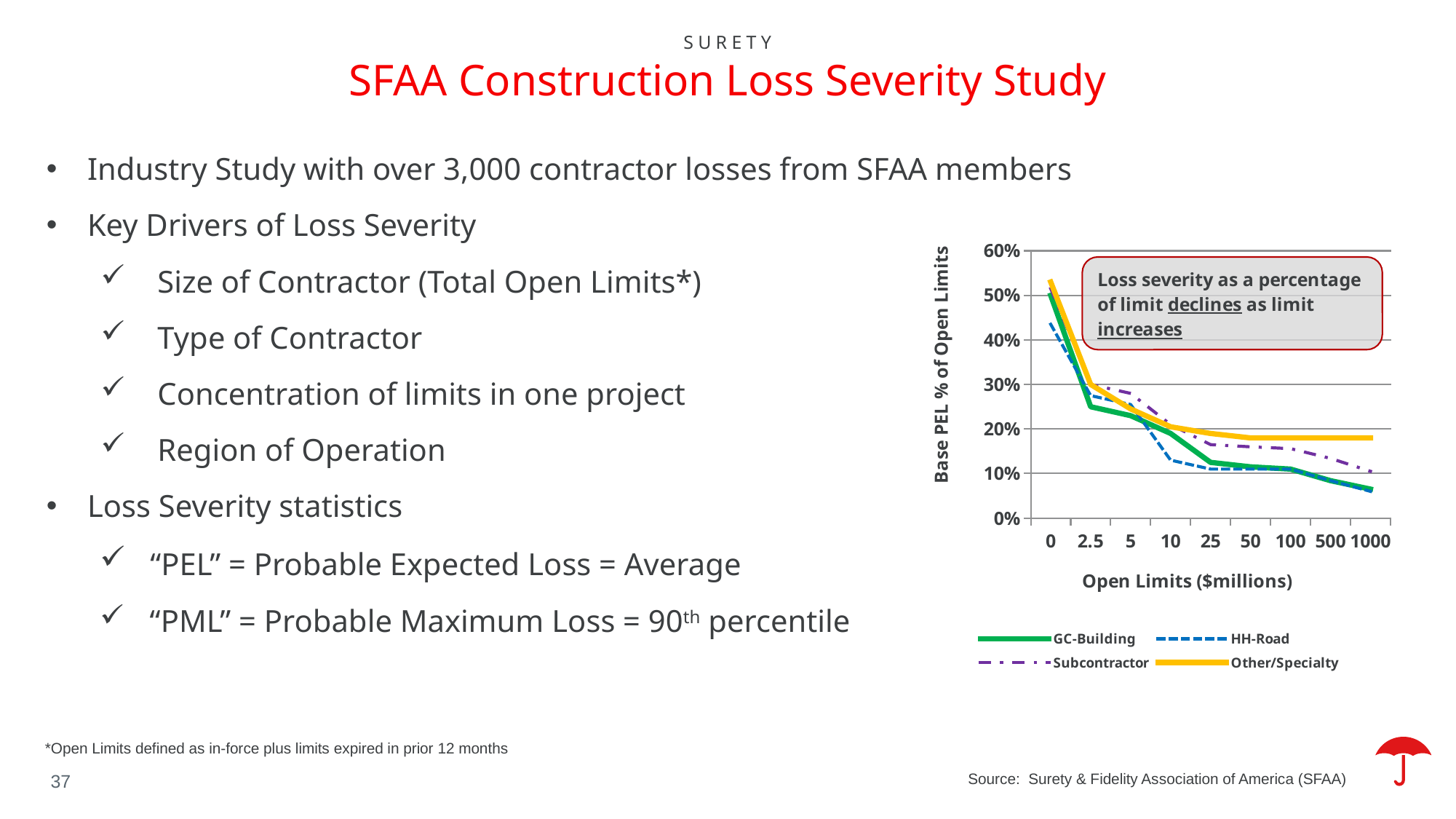
How many open-limit values are marked along the x axis of the chart? 9 Do the Base PEL % values rise or fall as Open Limits increase along the x axis? Fall Is the value for Other/Specialty at 0 ($millions) greater or less than 50%? greater Is the value for GC-Building at 1000 ($millions) greater or less than 10%? less What kind of chart is shown on the slide? Line chart Which series has the lowest Base PEL % at 0 ($millions)? HH-Road Is the value for Other/Specialty at 1000 ($millions) greater or less than 10%? greater How many series does the chart legend list? 4 What is the title of the chart's x axis? Open Limits ($millions) Which series has the highest Base PEL % at 1000 ($millions)? Other/Specialty At 10 ($millions), which series has the larger value, HH-Road or Subcontractor? Subcontractor